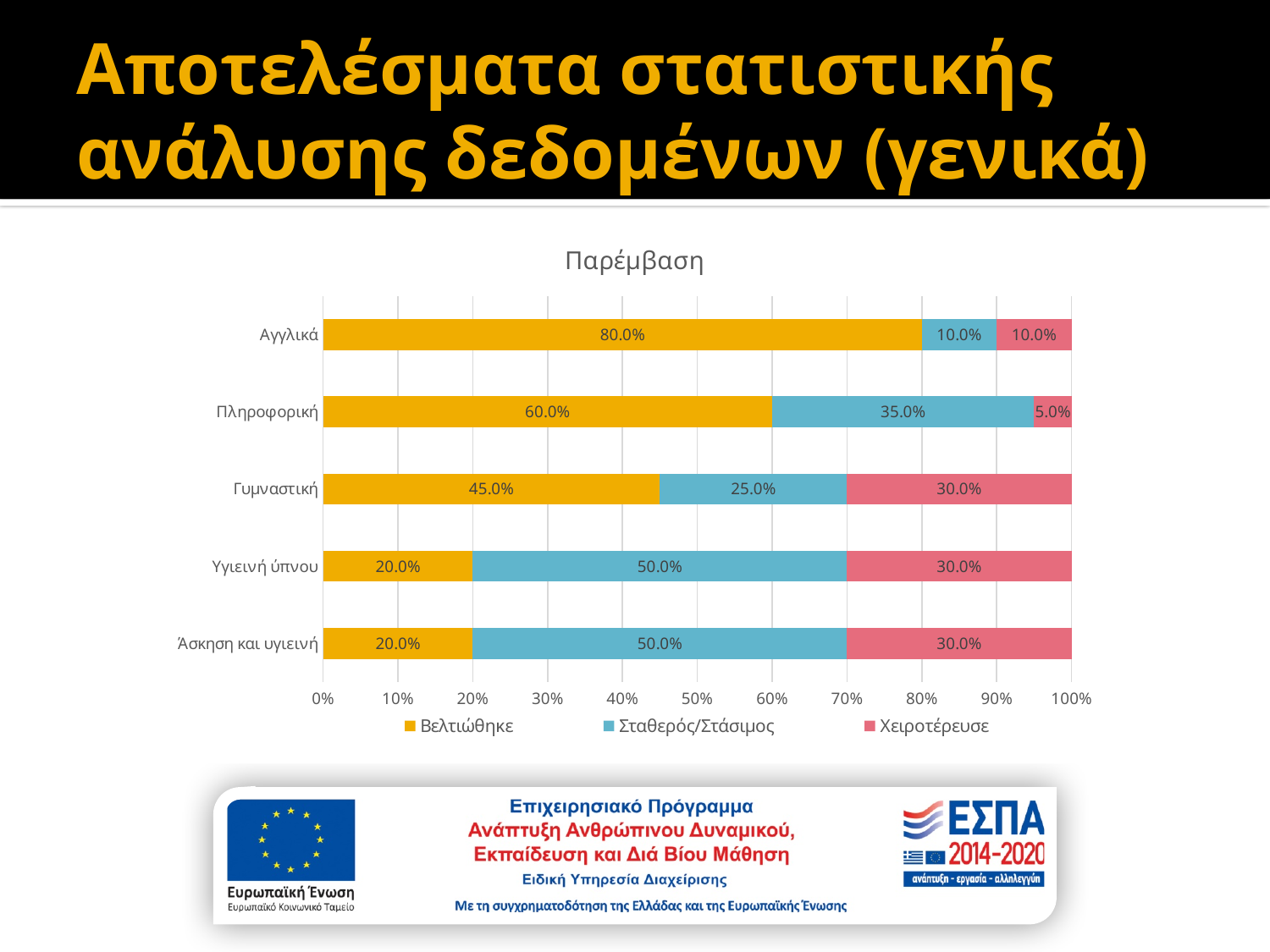
What is the Σταθερός/Στάσιμος value for Πληροφορική? 35.0% What is the Βελτιώθηκε value for Αγγλικά? 80.0% What kind of chart is shown on the slide? Stacked bar chart What is the Χειροτέρευσε value for Γυμναστική? 30.0% Which category has the lowest Χειροτέρευσε value? Πληροφορική What is the title of the chart? Παρέμβαση How many categories are shown on the chart? 5 How many series does the legend list? 3 What is the Βελτιώθηκε value for Υγιεινή ύπνου? 20.0% What is the difference between the Βελτιώθηκε values for Αγγλικά and Πληροφορική? 20.0% Which is larger: the Σταθερός/Στάσιμος value for Γυμναστική or for Υγιεινή ύπνου? Υγιεινή ύπνου Which category has the highest Βελτιώθηκε value? Αγγλικά